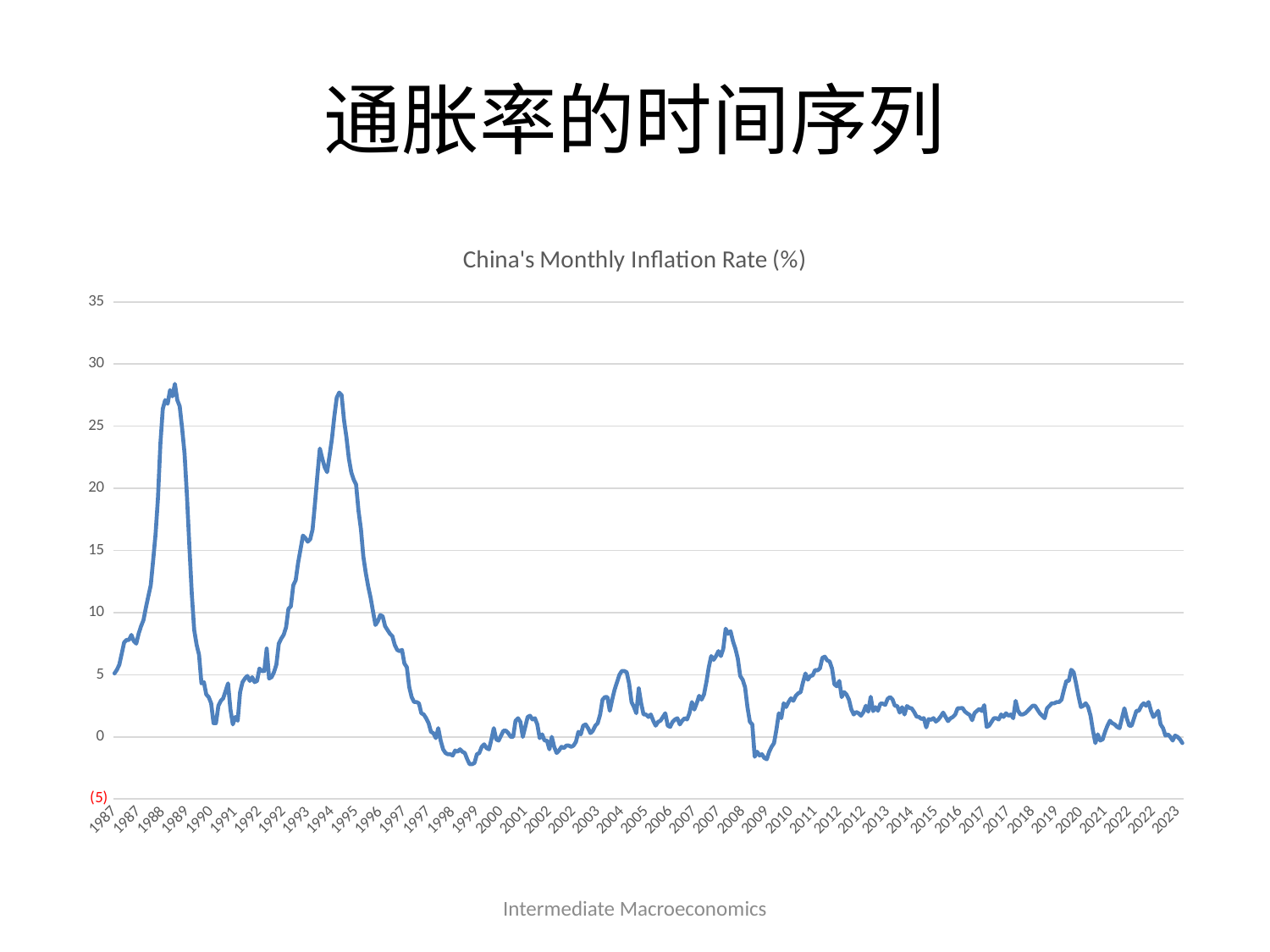
Is the inflation rate at the end of 2023 greater or less than 5? less Is the peak inflation rate around 2008 greater or less than 10? less What is the title of the chart? China's Monthly Inflation Rate (%) Is the peak inflation rate around 2008 greater or less than 5? greater What is the highest value shown on the vertical axis? 35 Does the inflation rate rise or fall between its 1994 peak and 1999? fall What kind of chart is shown on the slide? Line chart